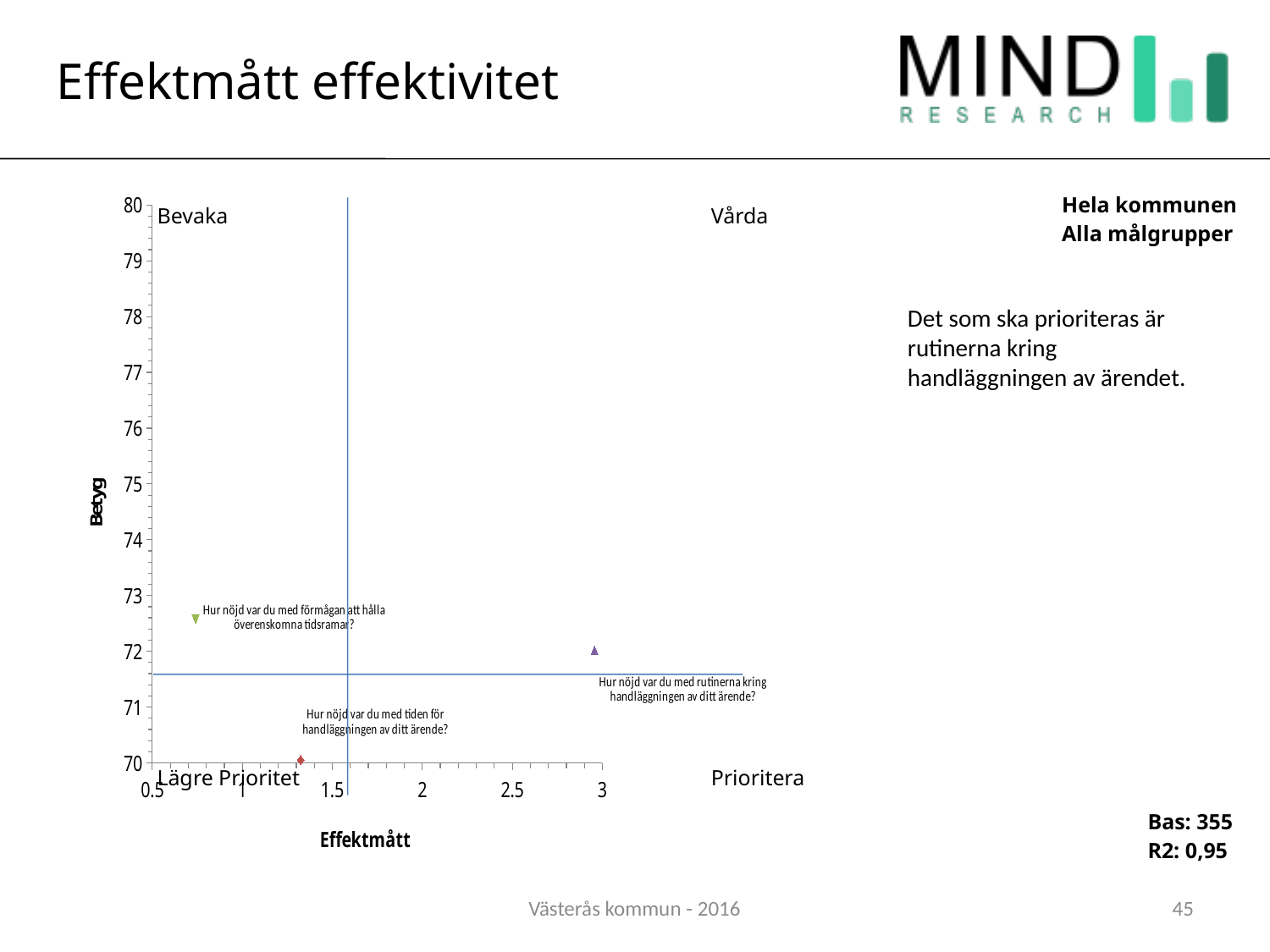
What kind of chart is shown on the slide? Scatter chart Which point has the lowest Effektmått value? Hur nöjd var du med förmågan att hålla överenskomna tidsramar? Which has a higher Effektmått value: 'Hur nöjd var du med tiden för handläggningen av ditt ärende?' or 'Hur nöjd var du med förmågan att hålla överenskomna tidsramar?' Hur nöjd var du med tiden för handläggningen av ditt ärende? Is the Effektmått value for 'Hur nöjd var du med rutinerna kring handläggningen av ditt ärende?' greater or less than 2.5? greater Which point has the lowest Betyg value? Hur nöjd var du med tiden för handläggningen av ditt ärende? What is the title of the horizontal axis of the chart? Effektmått Which point has the highest Betyg value? Hur nöjd var du med förmågan att hålla överenskomna tidsramar? Which point has the highest Effektmått value? Hur nöjd var du med rutinerna kring handläggningen av ditt ärende? How many data points are plotted in the chart? 3 What is the title of the vertical axis of the chart? Betyg Is the Betyg value for 'Hur nöjd var du med förmågan att hålla överenskomna tidsramar?' greater or less than 72? greater Is the Betyg value for 'Hur nöjd var du med tiden för handläggningen av ditt ärende?' greater or less than 71? less